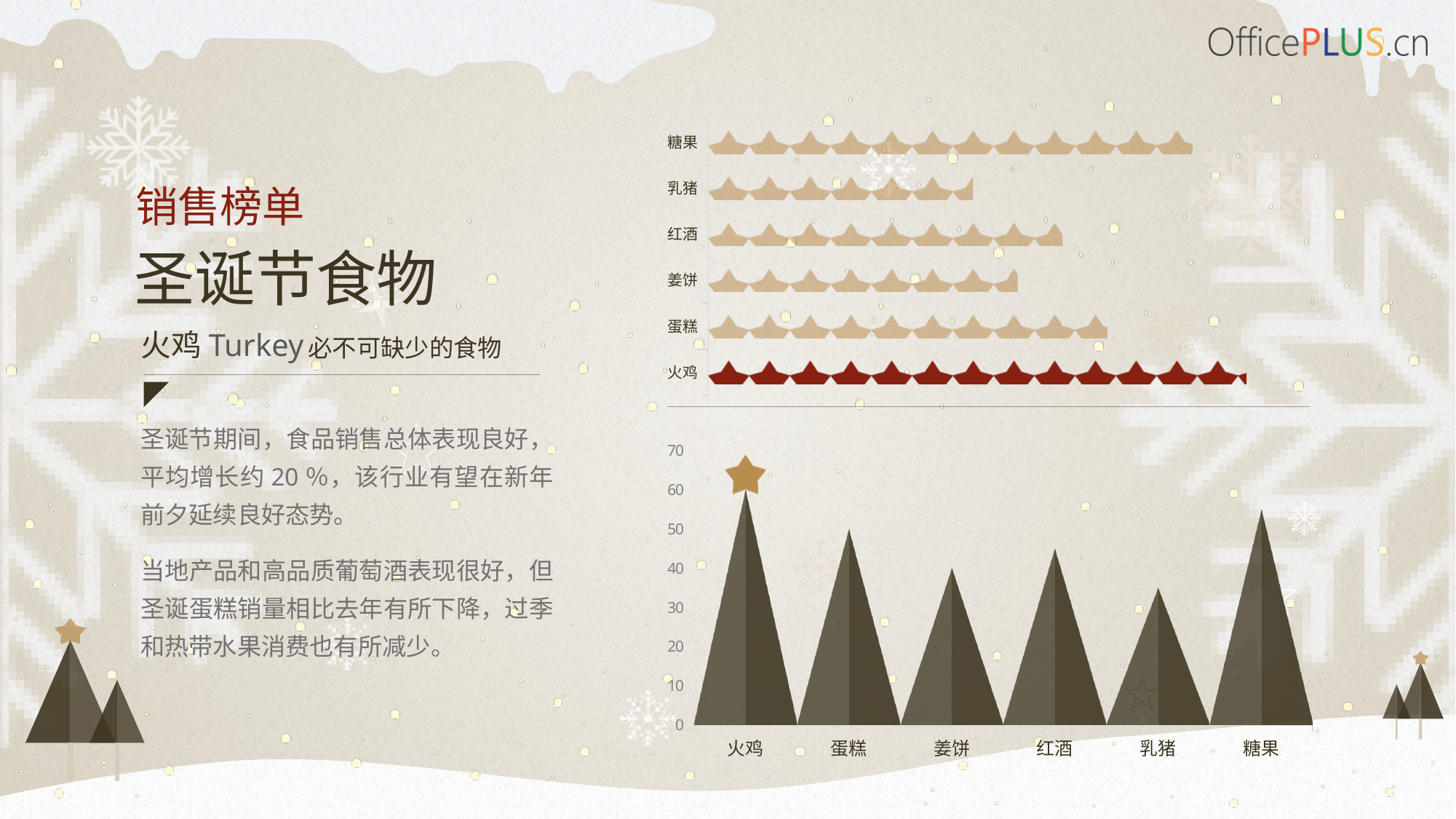
In the top chart, which category has the shortest bar? 乳猪 In the bottom chart, which category has the highest value? 火鸡 In the bottom chart, is the value for 姜饼 greater or less than 30? greater In the bottom chart, is the value for 乳猪 greater or less than 40? less How many categories are shown on the x axis of the bottom chart? 6 In the top chart, which category has the longest bar? 火鸡 In the top chart, which is larger, the value for 糖果 or the value for 姜饼? 糖果 In the top chart, which category's bar is coloured red? 火鸡 In the bottom chart, is the value for 火鸡 greater or less than 50? greater In the bottom chart, which category has the lowest value? 乳猪 In the bottom chart, which is larger, the value for 糖果 or the value for 乳猪? 糖果